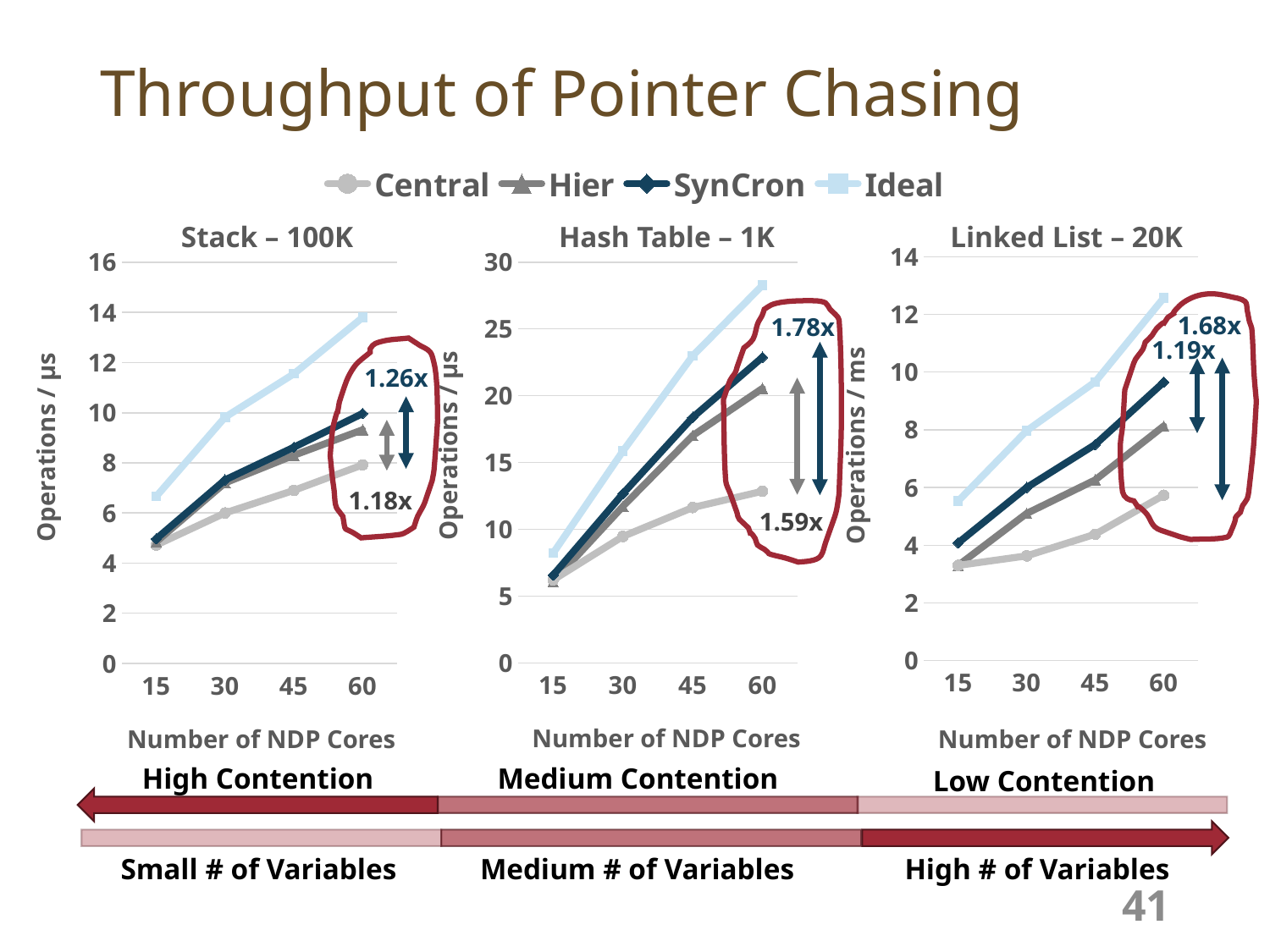
How many x-axis points (numbers of NDP cores) are plotted in the Hash Table – 1K chart? 4 What kind of chart is the Stack – 100K chart? line chart In the Hash Table – 1K chart, which series has the lowest value at 60 NDP cores? Central In the Stack – 100K chart, which series has the highest value at 60 NDP cores? Ideal What is the x-axis label of the Stack – 100K chart? Number of NDP Cores In the Linked List – 20K chart, does the SynCron series rise or fall as the number of NDP cores increases? rise In the Linked List – 20K chart, is the value for Central at 60 NDP cores greater or less than 8? less In the Stack – 100K chart, is the value for Central at 60 NDP cores greater or less than 10? less In the Linked List – 20K chart, which is larger at 60 NDP cores, SynCron or Hier? SynCron What is the y-axis label of the Linked List – 20K chart? Operations / ms In the Hash Table – 1K chart, is the value for Ideal at 60 NDP cores greater or less than 25? greater How many series does the legend list? 4